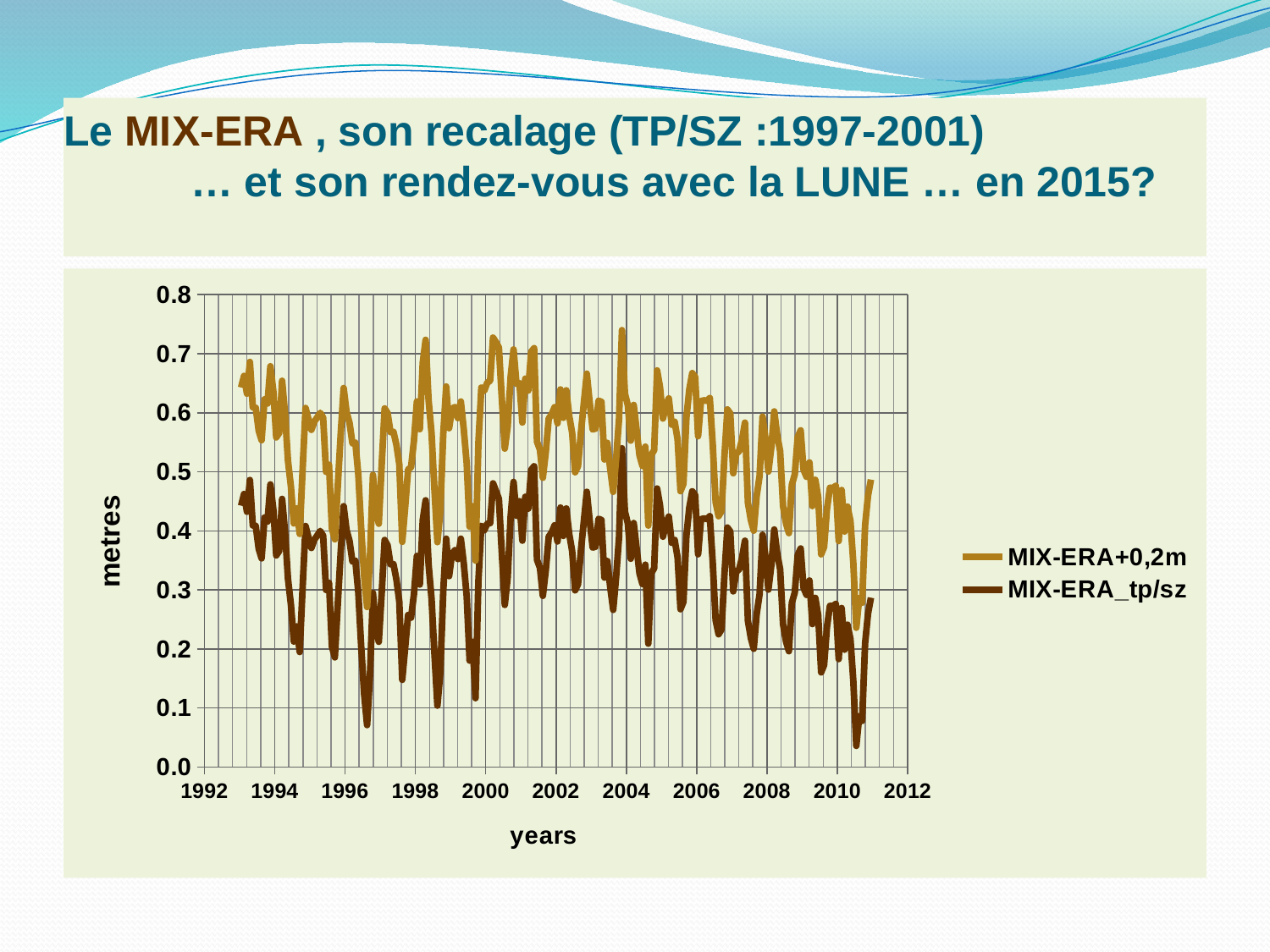
Is the highest value of the MIX-ERA+0,2m series (around 2004) greater or less than 0.7? greater Do the values of the MIX-ERA+0,2m series generally rise or fall between 2004 and 2010? fall Is the lowest value of the MIX-ERA_tp/sz series (around 2010) greater or less than 0.1? less What kind of chart is shown on the slide? line chart Which series generally has the higher values, MIX-ERA+0,2m or MIX-ERA_tp/sz? MIX-ERA+0,2m Is the lowest value of the MIX-ERA+0,2m series greater or less than 0.2? greater What is the label of the vertical axis? metres What are the two series named in the legend? MIX-ERA+0,2m and MIX-ERA_tp/sz How many series does the legend list? 2 What is the highest tick value shown on the vertical axis? 0.8